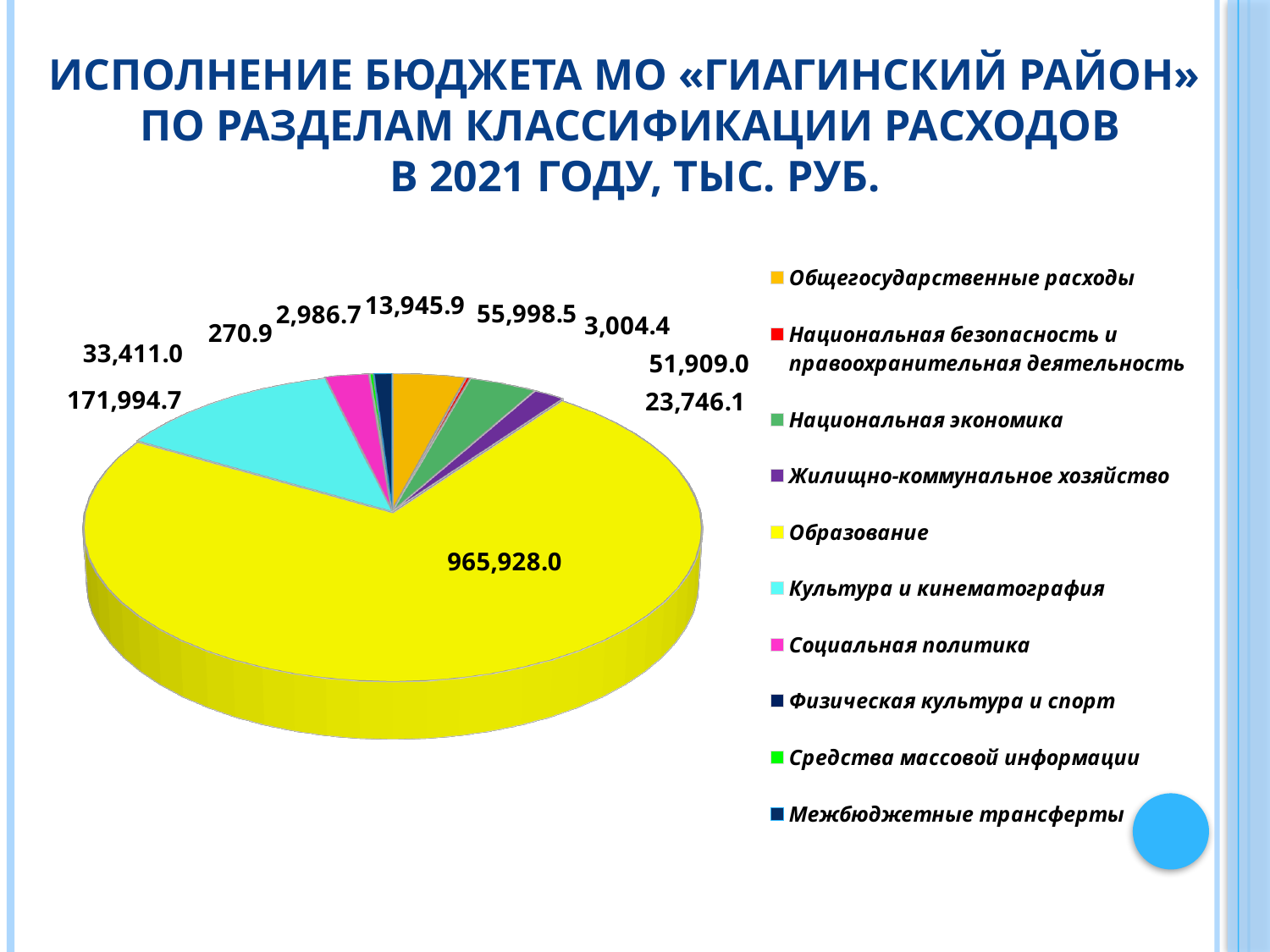
What is the value for Культура и кинематография? 171,994.7 What is the value for Общегосударственные расходы? 55,998.5 Which is larger, Образование or Культура и кинематография? Образование What is the value for Образование? 965,928.0 What is the difference between the values for Образование and Культура и кинематография? 793,933.3 How many categories does the legend of the pie chart list? 10 Which category has the largest slice of the pie? Образование What is the smallest value labelled on the pie chart? 270.9 What is the value for Жилищно-коммунальное хозяйство? 23,746.1 What kind of chart is shown on the slide? Pie chart What is the value for Национальная экономика? 51,909.0 What is the value for Социальная политика? 33,411.0